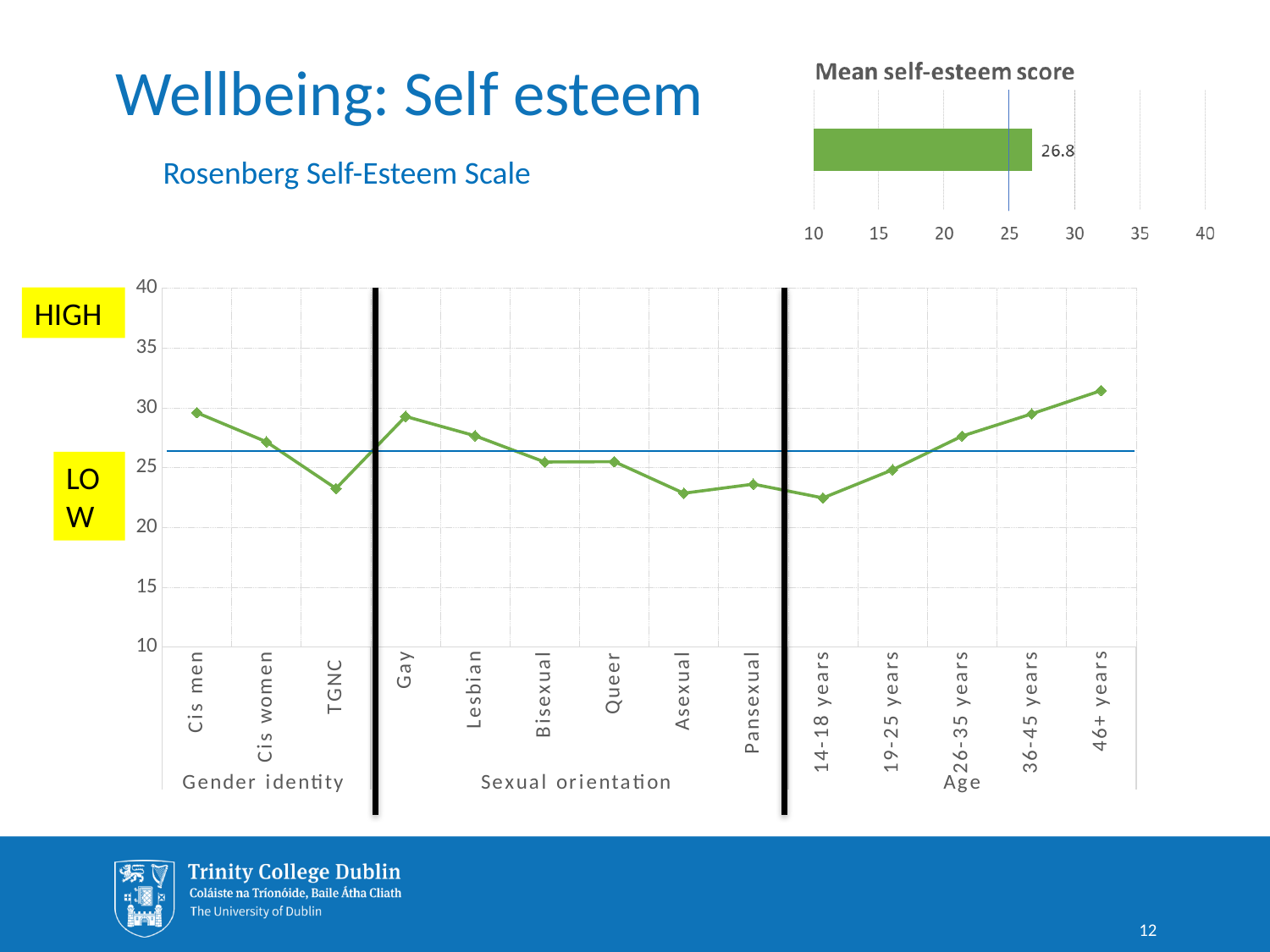
On the large line chart at the bottom, which category has the highest value? 46+ years On the large line chart at the bottom, how many categories are plotted along the x axis? 14 On the large line chart at the bottom, which is larger, the value for Cis men or the value for TGNC? Cis men On the large line chart at the bottom, what are the three group labels shown beneath the x axis? Gender identity, Sexual orientation, Age On the 'Mean self-esteem score' chart at the top right, what is the value shown on the bar? 26.8 On the large line chart at the bottom, is the value for TGNC greater or less than 25? less On the large line chart at the bottom, which of the age categories has the lowest value? 14-18 years What kind of chart is the large chart at the bottom of the slide? line chart On the large line chart at the bottom, do the values rise or fall across the age categories from 14-18 years to 46+ years? rise On the large line chart at the bottom, is the value for 46+ years greater or less than 30? greater What kind of chart is the 'Mean self-esteem score' chart at the top right of the slide? bar chart On the large line chart at the bottom, is the value for Asexual greater or less than 25? less